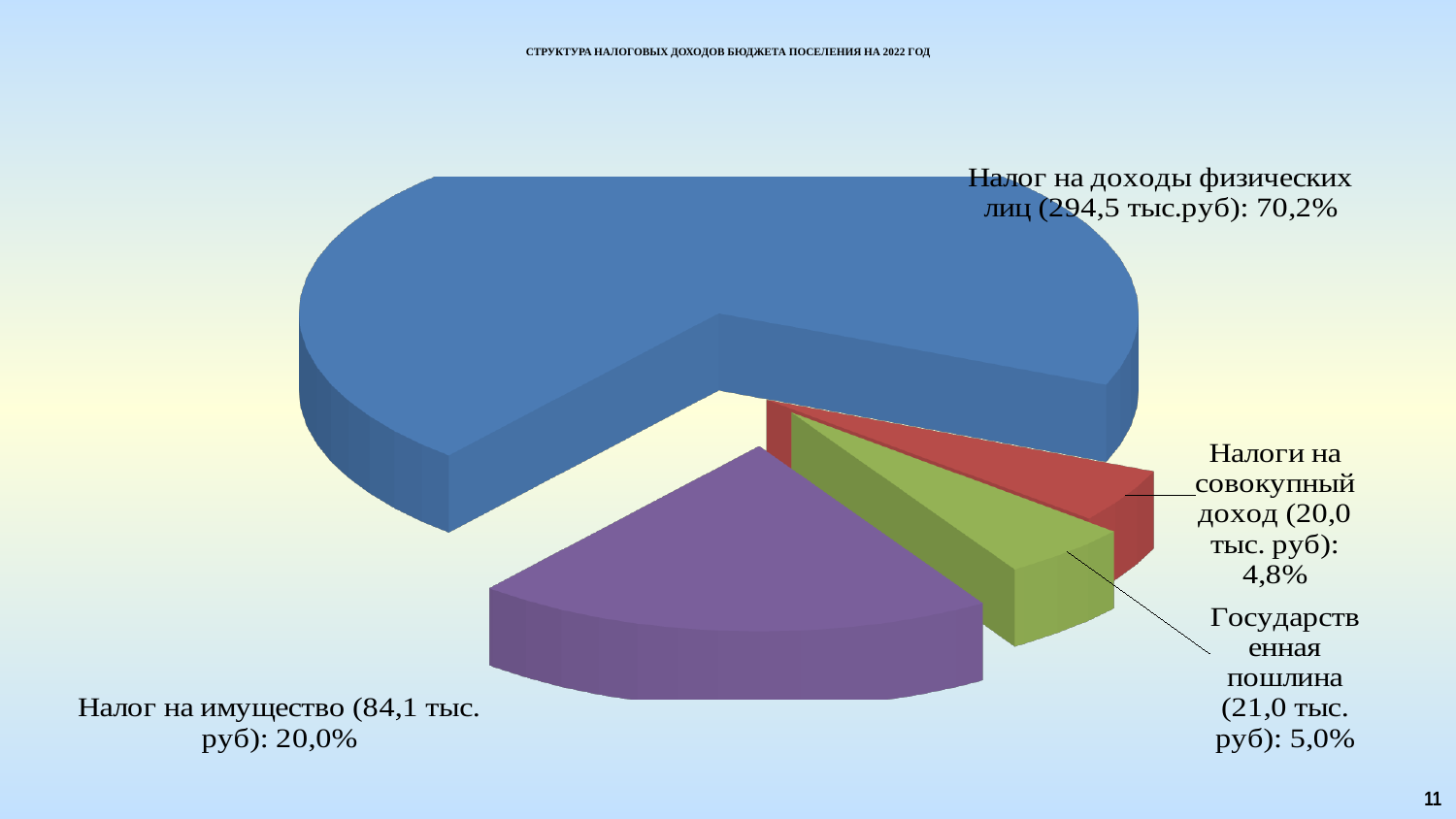
Which slice of the pie is the largest? Налог на доходы физических лиц What share of the pie does "Государственная пошлина" have? 5,0% How many slices does the pie chart have? 4 What kind of chart is shown on the slide? Pie chart What amount in тыс. руб is shown for "Налог на имущество"? 84,1 тыс. руб What is the title of the chart? СТРУКТУРА НАЛОГОВЫХ ДОХОДОВ БЮДЖЕТА ПОСЕЛЕНИЯ НА 2022 ГОД What share of the pie does "Налоги на совокупный доход" have? 4,8% What amount in тыс. руб is shown for "Налог на доходы физических лиц"? 294,5 тыс.руб What is the difference in percentage points between the shares of "Налог на имущество" and "Государственная пошлина"? 15,0% Which slice of the pie is the smallest? Налоги на совокупный доход What share of the pie does "Налог на доходы физических лиц" have? 70,2%